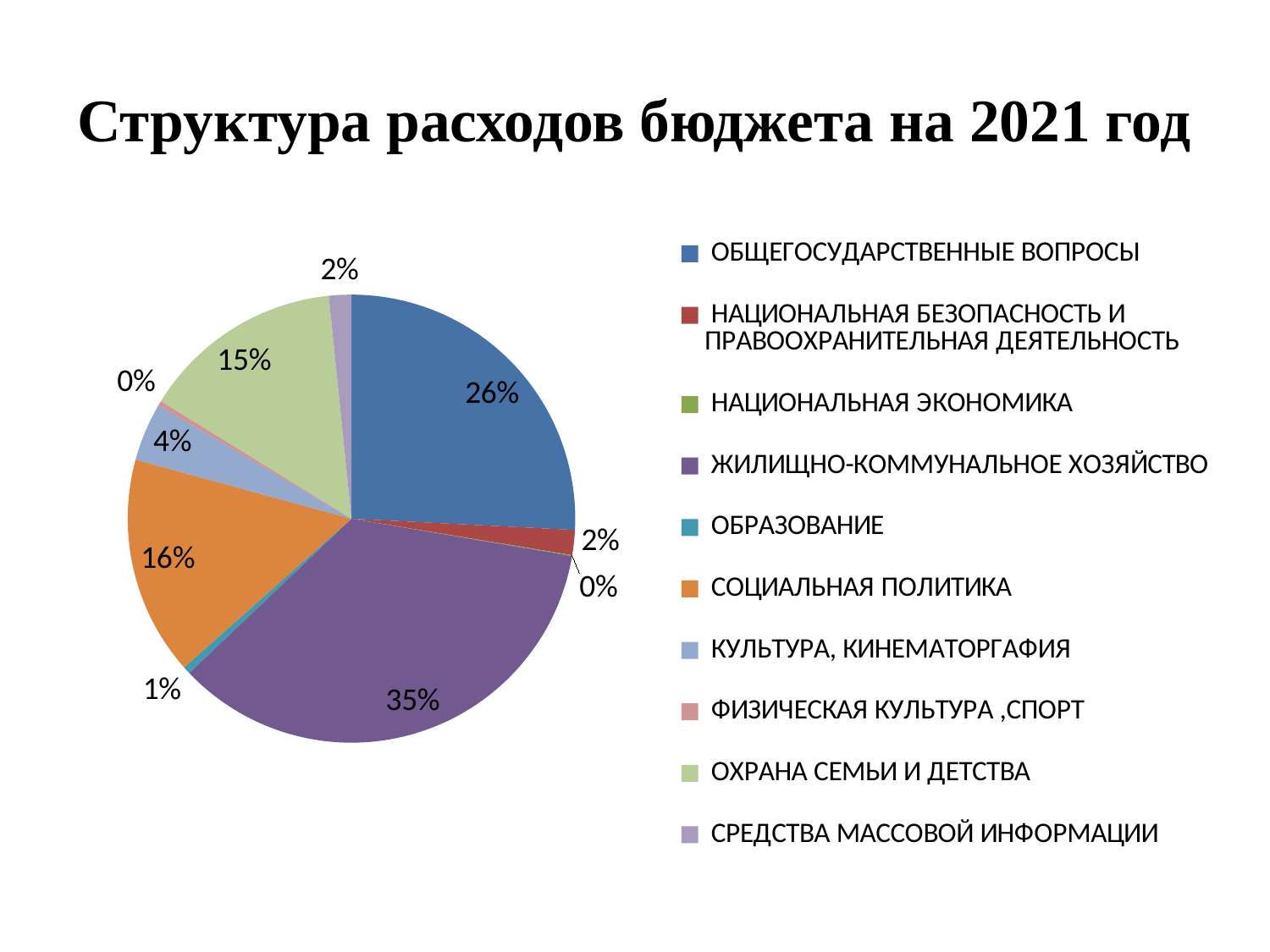
What colour is the slice for СОЦИАЛЬНАЯ ПОЛИТИКА? orange What is the title of the chart on the slide? Структура расходов бюджета на 2021 год What share of the pie does ОБЩЕГОСУДАРСТВЕННЫЕ ВОПРОСЫ have? 26% Which category has the largest slice of the pie? ЖИЛИЩНО-КОММУНАЛЬНОЕ ХОЗЯЙСТВО What share of the pie does ЖИЛИЩНО-КОММУНАЛЬНОЕ ХОЗЯЙСТВО have? 35% What type of chart is shown on the slide? pie chart What share of the pie does КУЛЬТУРА, КИНЕМАТОРГАФИЯ have? 4% How many categories does the legend of the pie chart list? 10 What is the difference in percentage points between the ЖИЛИЩНО-КОММУНАЛЬНОЕ ХОЗЯЙСТВО slice and the ОБЩЕГОСУДАРСТВЕННЫЕ ВОПРОСЫ slice? 9% Which is larger: the slice for СОЦИАЛЬНАЯ ПОЛИТИКА or the slice for ОХРАНА СЕМЬИ И ДЕТСТВА? СОЦИАЛЬНАЯ ПОЛИТИКА